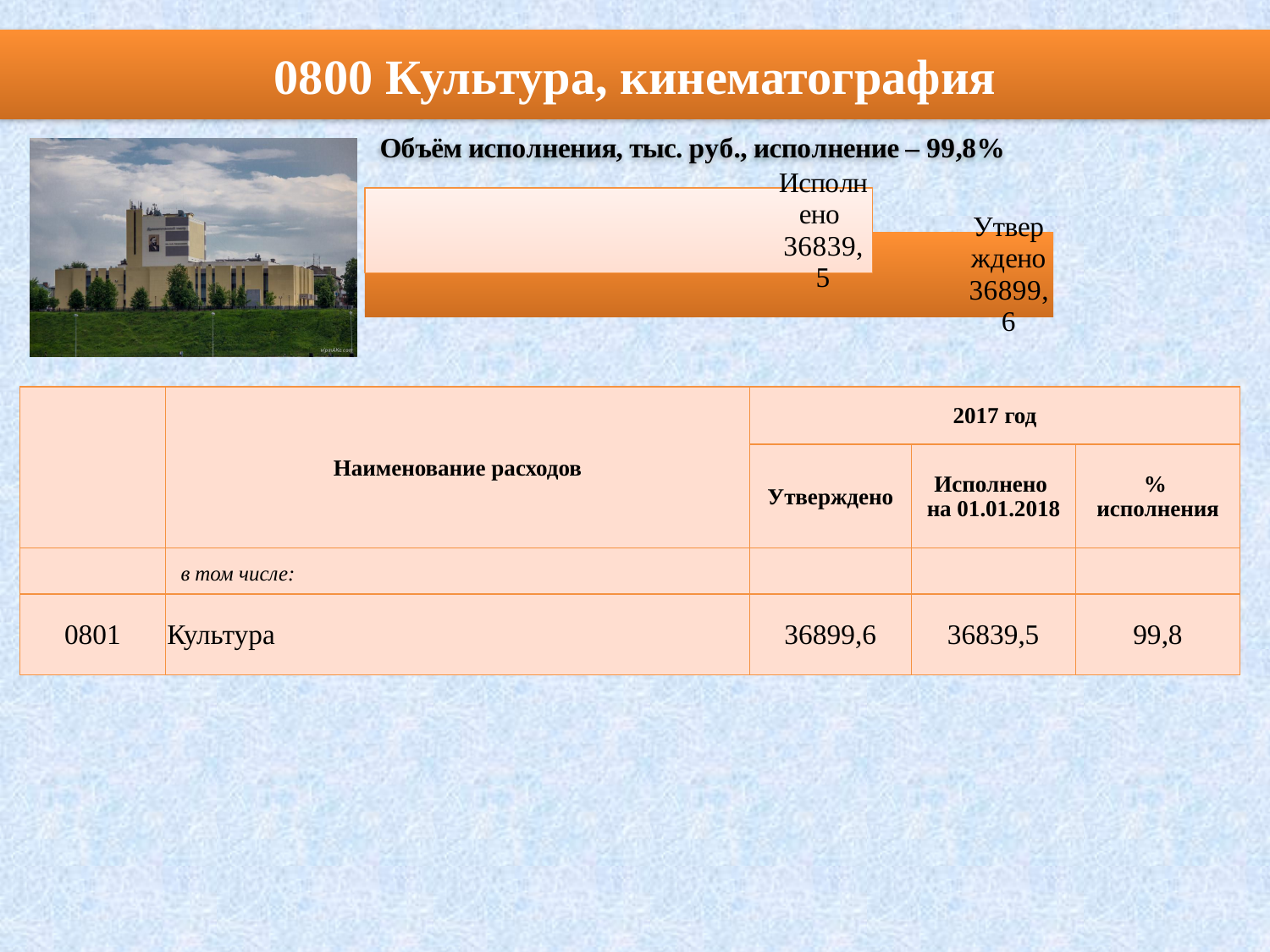
How many bars are plotted in the chart? 2 What kind of chart is shown on the slide? Bar chart What is the title of the chart? Объём исполнения, тыс. руб., исполнение – 99,8% What value is shown for the bar labelled Исполнено? 36839,5 Which bar shows the largest value? Утверждено Which bar shows the smallest value? Исполнено Which bar has the higher value, Исполнено or Утверждено? Утверждено What colour is the Утверждено bar? Orange What value is shown for the bar labelled Утверждено? 36899,6 What is the difference between the Утверждено value and the Исполнено value? 60,1